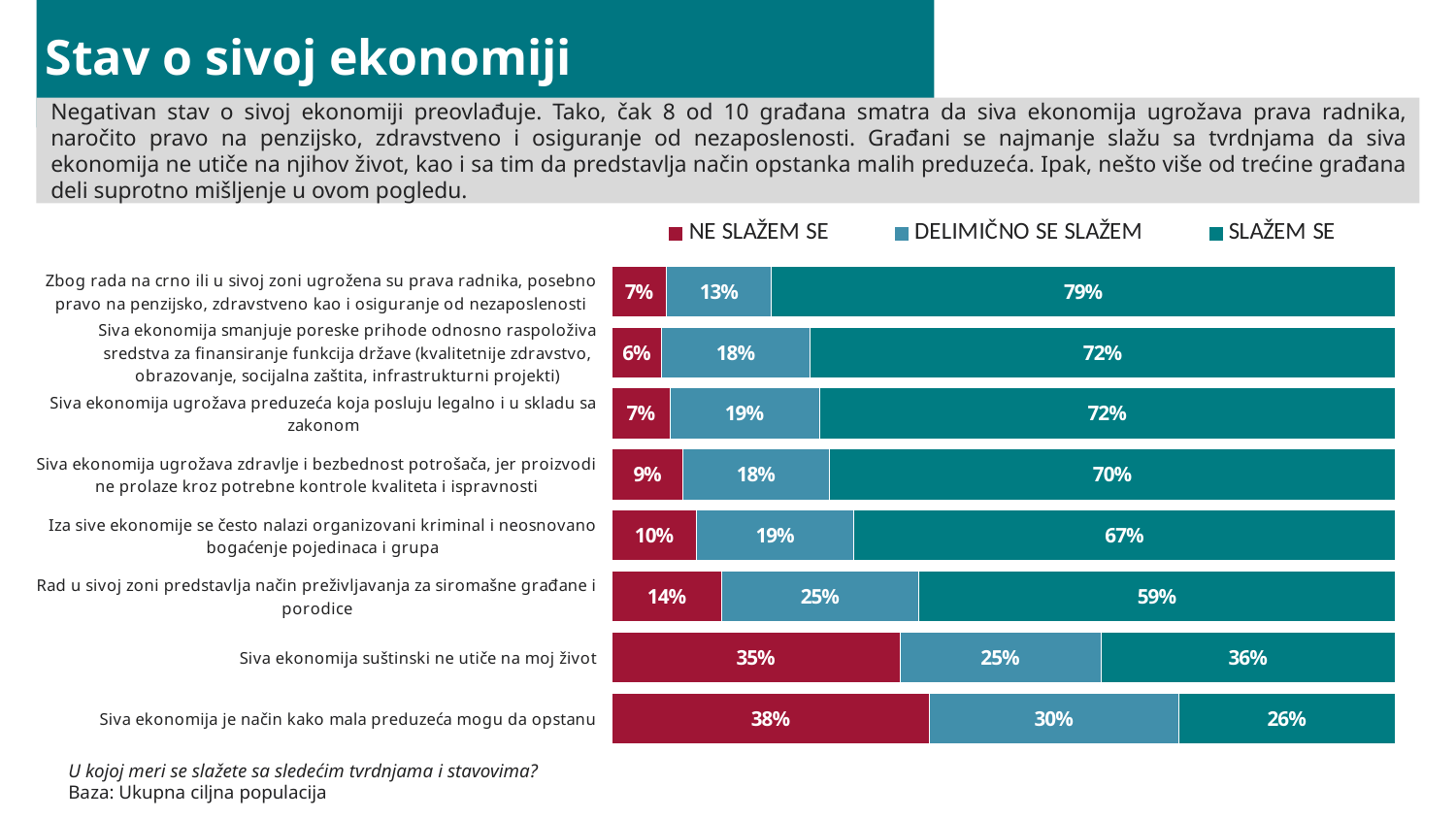
What is the total of the three printed values for the statement 'Iza sive ekonomije se često nalazi organizovani kriminal i neosnovano bogaćenje pojedinaca i grupa'? 96% What is the 'SLAŽEM SE' value for the statement 'Zbog rada na crno ili u sivoj zoni ugrožena su prava radnika...'? 79% What is the 'DELIMIČNO SE SLAŽEM' value for the statement 'Rad u sivoj zoni predstavlja način preživljavanja za siromašne građane i porodice'? 25% How many series does the legend list? 3 Which is larger: the 'NE SLAŽEM SE' value for 'Siva ekonomija suštinski ne utiče na moj život' or for 'Siva ekonomija je način kako mala preduzeća mogu da opstanu'? Siva ekonomija je način kako mala preduzeća mogu da opstanu Which legend entry is shown in dark red? NE SLAŽEM SE What type of chart is shown on the slide? stacked bar chart Which statement has the lowest 'SLAŽEM SE' value? Siva ekonomija je način kako mala preduzeća mogu da opstanu Which statement has the highest 'SLAŽEM SE' value? Zbog rada na crno ili u sivoj zoni ugrožena su prava radnika, posebno pravo na penzijsko, zdravstveno kao i osiguranje od nezaposlenosti What is the difference between the 'SLAŽEM SE' value for 'Siva ekonomija suštinski ne utiče na moj život' and its 'NE SLAŽEM SE' value? 1% How many statements (categories) are plotted in the chart? 8 What is the 'NE SLAŽEM SE' value for the statement 'Siva ekonomija je način kako mala preduzeća mogu da opstanu'? 38%